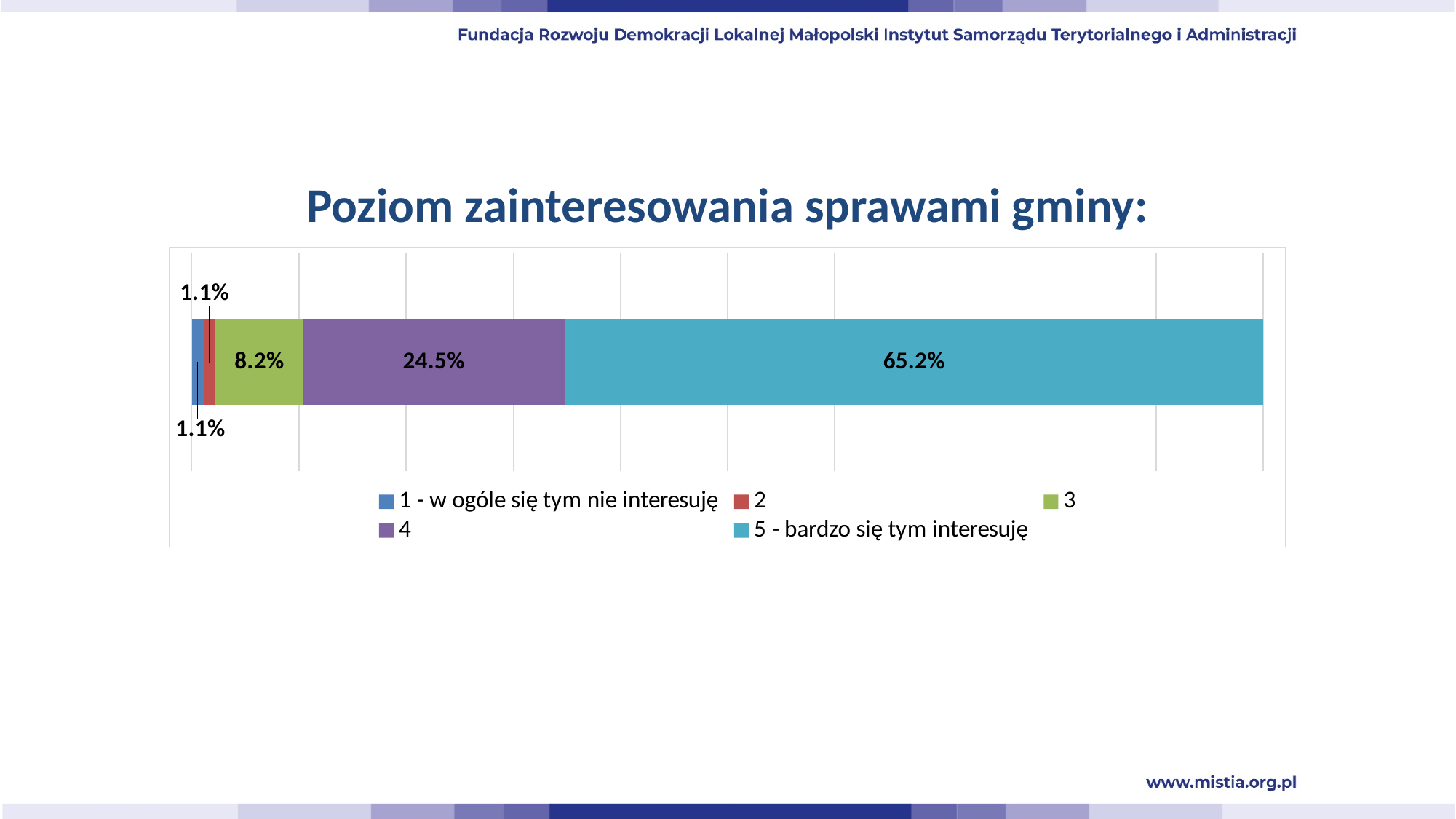
What is the title of the chart? Poziom zainteresowania sprawami gminy: What is the value for series "4"? 24.5% What is the value for series "1 - w ogóle się tym nie interesuję"? 1.1% What is the difference between the values for series "5 - bardzo się tym interesuję" and series "4"? 40.7% How many series does the legend list? 5 Which is larger, the value for series "3" or the value for series "4"? 4 What kind of chart is shown on the slide? Stacked bar chart Which series has the highest value? 5 - bardzo się tym interesuję What is the value for series "3"? 8.2% What is the value for series "2"? 1.1% What is the difference between the values for series "4" and series "3"? 16.3% What is the value for series "5 - bardzo się tym interesuję"? 65.2%